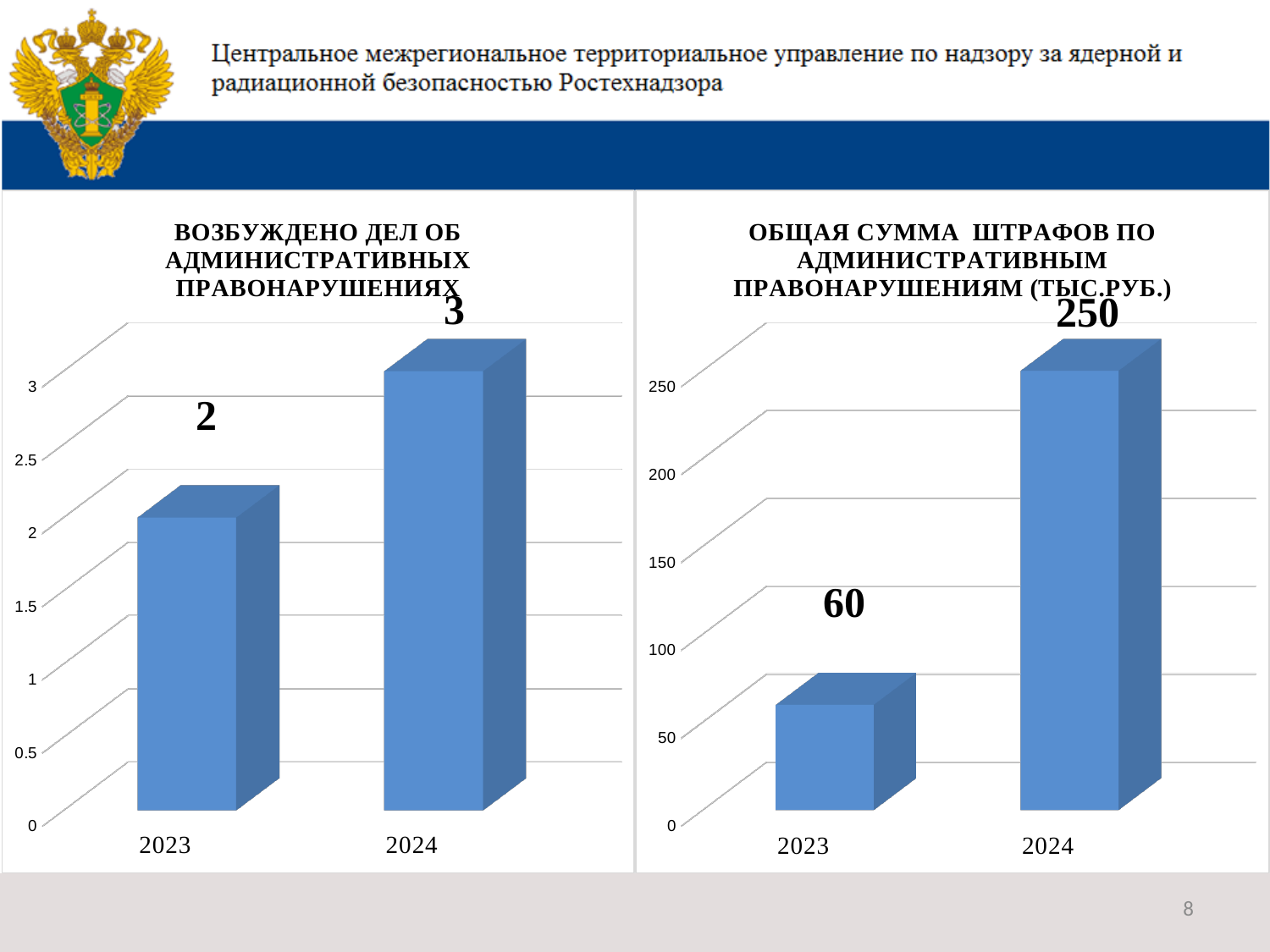
In the right chart (ОБЩАЯ СУММА ШТРАФОВ), do the values rise or fall from 2023 to 2024? Rise In the right chart (ОБЩАЯ СУММА ШТРАФОВ), which is larger: the value for 2023 or for 2024? 2024 How many categories are shown on the x axis of the left chart (ВОЗБУЖДЕНО ДЕЛ)? 2 In the right chart (ОБЩАЯ СУММА ШТРАФОВ ПО АДМИНИСТРАТИВНЫМ ПРАВОНАРУШЕНИЯМ), what is the value for 2024? 250 In the left chart (ВОЗБУЖДЕНО ДЕЛ ОБ АДМИНИСТРАТИВНЫХ ПРАВОНАРУШЕНИЯХ), what is the value for 2023? 2 What kind of chart is the right chart (ОБЩАЯ СУММА ШТРАФОВ)? Bar chart In the right chart (ОБЩАЯ СУММА ШТРАФОВ ПО АДМИНИСТРАТИВНЫМ ПРАВОНАРУШЕНИЯМ), what is the value for 2023? 60 In the left chart (ВОЗБУЖДЕНО ДЕЛ), which year has the lowest value? 2023 In the left chart (ВОЗБУЖДЕНО ДЕЛ ОБ АДМИНИСТРАТИВНЫХ ПРАВОНАРУШЕНИЯХ), what is the value for 2024? 3 In the right chart (ОБЩАЯ СУММА ШТРАФОВ), what is the difference between the 2024 and 2023 values? 190 In the left chart (ВОЗБУЖДЕНО ДЕЛ), what is the difference between the 2024 and 2023 values? 1 In the right chart (ОБЩАЯ СУММА ШТРАФОВ), which year has the highest value? 2024